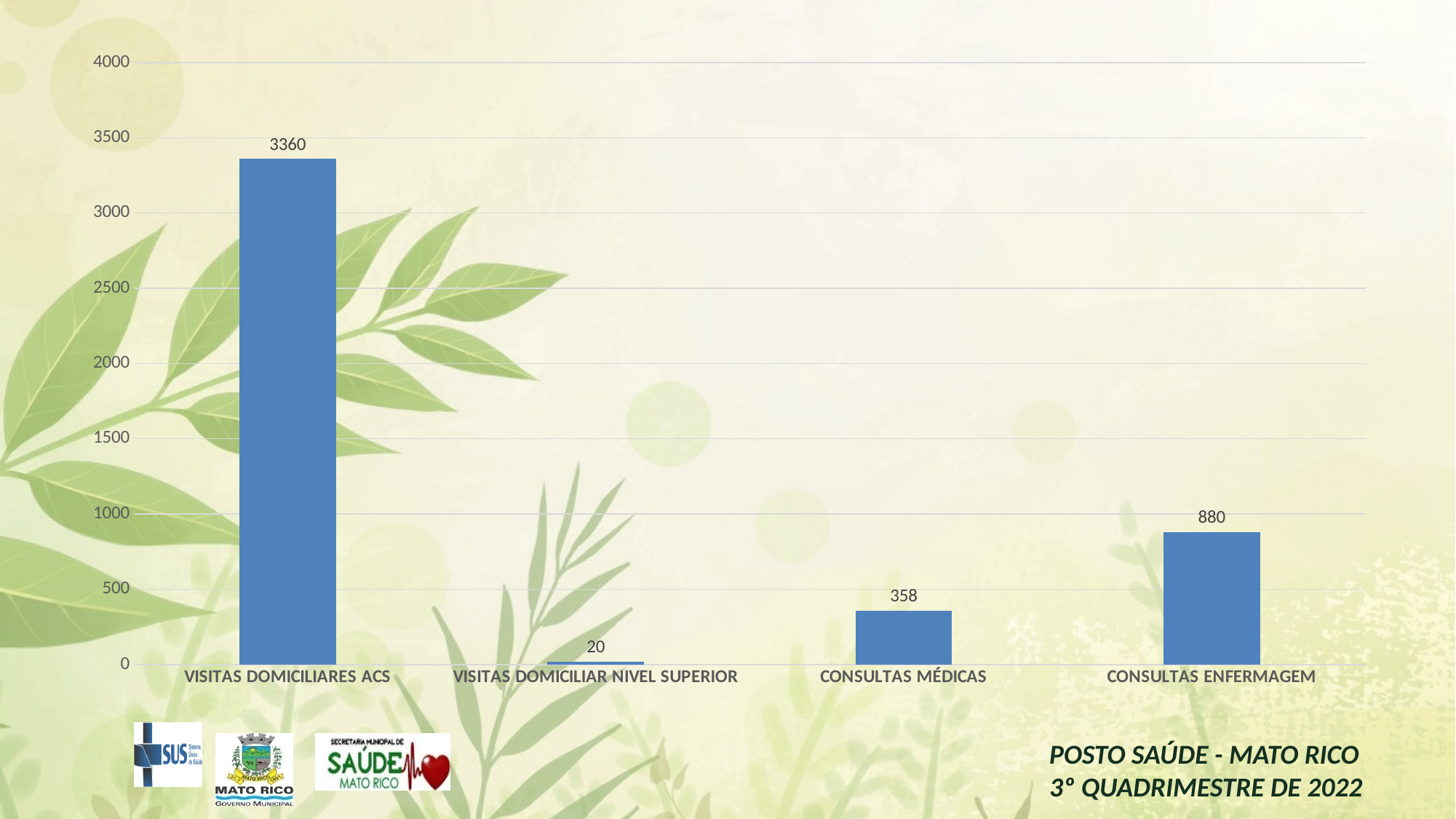
Is the value for CONSULTAS MÉDICAS greater or less than 500? less What is the value for VISITAS DOMICILIARES ACS? 3360 What is the difference between the values for CONSULTAS ENFERMAGEM and CONSULTAS MÉDICAS? 522 What is the value for VISITAS DOMICILIAR NIVEL SUPERIOR? 20 How many categories are shown in the chart? 4 Which category has the lowest value? VISITAS DOMICILIAR NIVEL SUPERIOR What is the value for CONSULTAS ENFERMAGEM? 880 What is the value for CONSULTAS MÉDICAS? 358 What kind of chart is shown on the slide? bar chart Which category has the highest value? VISITAS DOMICILIARES ACS Which is larger, CONSULTAS MÉDICAS or CONSULTAS ENFERMAGEM? CONSULTAS ENFERMAGEM What is the difference between the values for VISITAS DOMICILIARES ACS and CONSULTAS ENFERMAGEM? 2480